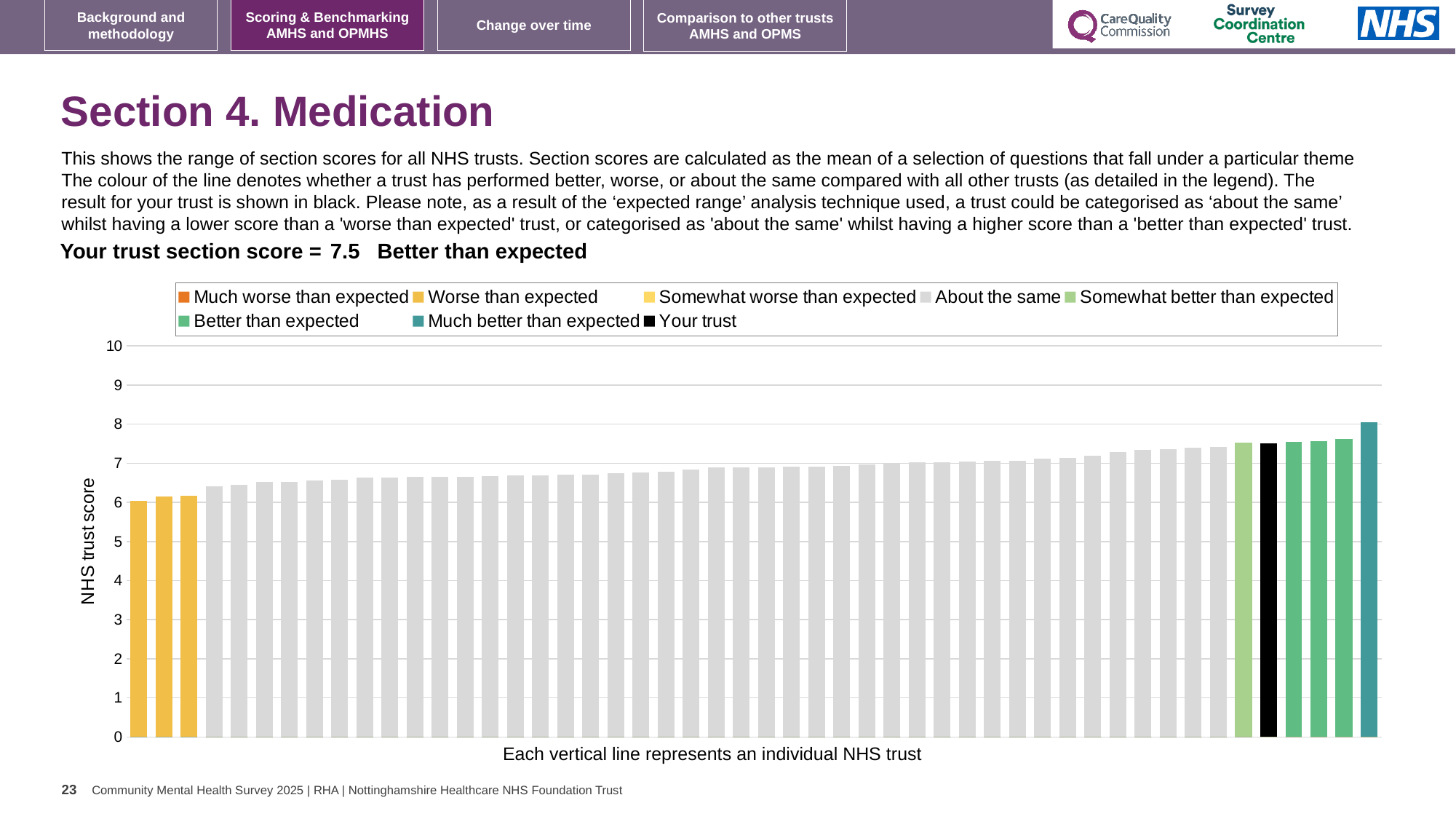
What kind of chart is shown on the slide? bar chart What is the section score for your trust shown on the slide? 7.5 What does the x-axis caption say each vertical line represents? an individual NHS trust Is the value of the lowest bar in the chart greater or less than 7? less How many bars are coloured black for 'Your trust'? 1 Is the value for your trust's bar greater or less than 7? greater Which legend category does the tallest bar in the chart belong to? Much better than expected Do the bar values rise or fall from left to right along the x axis? rise Is your trust's bar higher or lower than the tallest bar in the chart? lower What is the label on the vertical axis of the chart? NHS trust score How many entries does the chart legend list? 8 Is the value for your trust's bar greater or less than 8? less